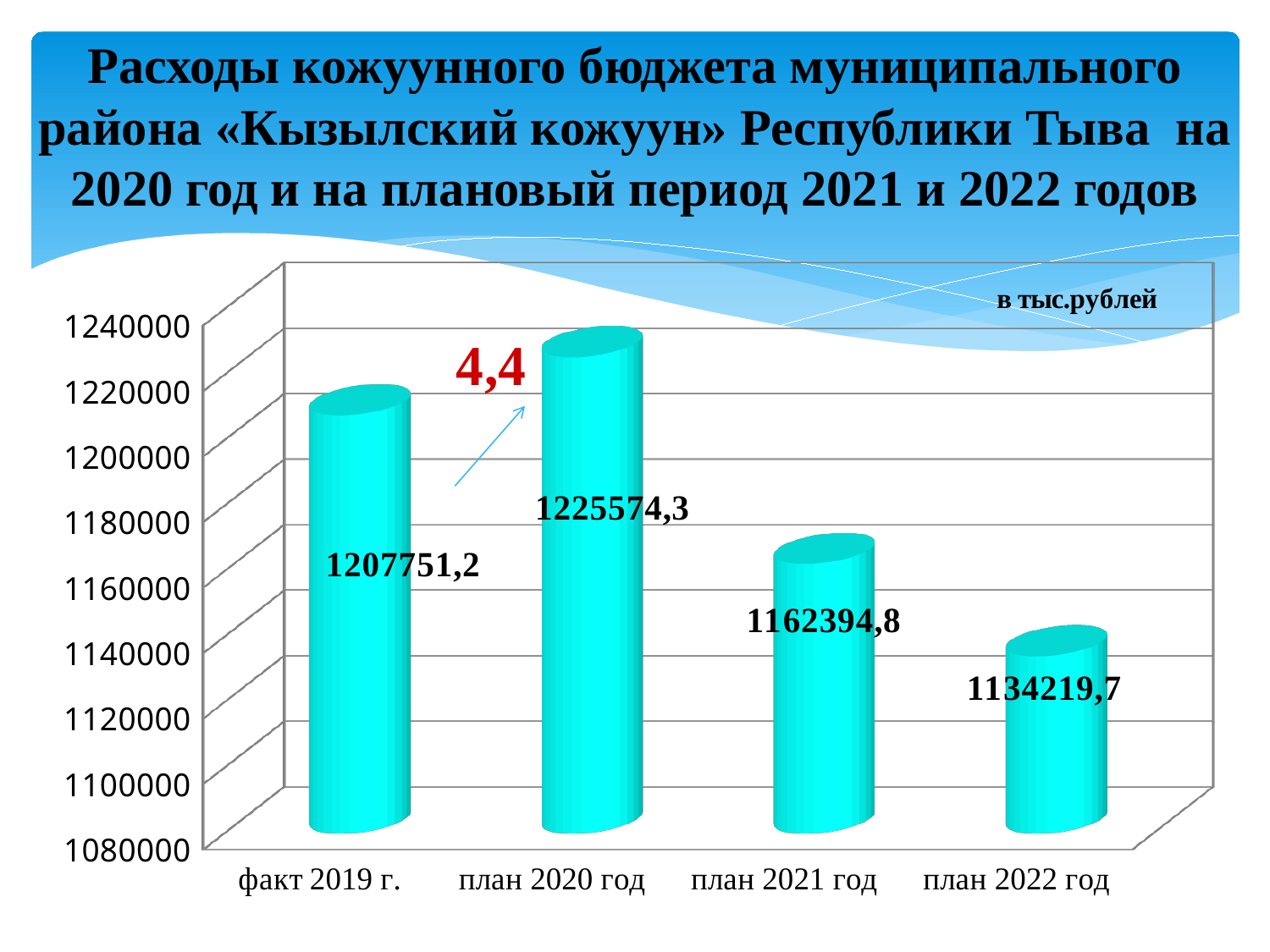
What is the difference between the values for план 2020 год and факт 2019 г.? 17823,1 Which category has the lowest value? план 2022 год What is the value for факт 2019 г.? 1207751,2 In what units are the values on the chart expressed, according to the note in the top right of the chart? в тыс.рублей Which category has the highest value? план 2020 год What kind of chart is shown on the slide? bar chart Which is larger, the value for план 2021 год or the value for план 2022 год? план 2021 год How many categories are shown on the x axis? 4 What is the value for план 2020 год? 1225574,3 What is the difference between the values for план 2021 год and план 2022 год? 28175,1 Is the value for план 2021 год greater or less than 1180000? less What is the value for план 2022 год? 1134219,7